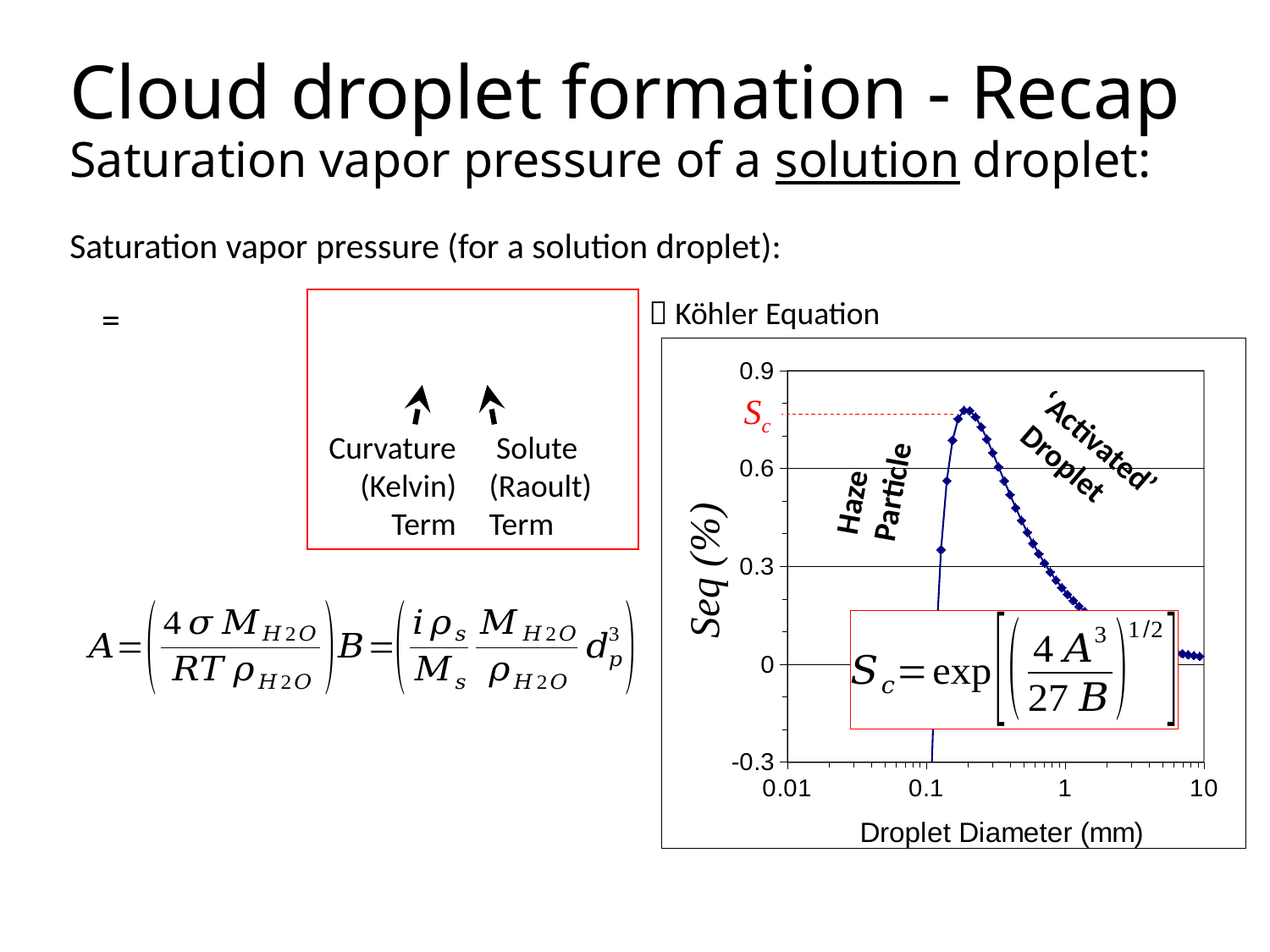
What label is written on the chart to the left of the curve's peak? Haze Particle What kind of chart is shown on the slide? line chart Is the peak value of the curve greater or less than 0.9? less What is the label of the x axis of the chart? Droplet Diameter (mm) Is the value of the curve at a droplet diameter of 10 mm greater or less than 0.3? less Is the value of the curve at a droplet diameter of 1 mm greater or less than 0.6? less After the peak, do the values of the curve rise or fall as droplet diameter increases? fall How many labelled tick values are shown on the y axis? 5 Between 0.1 mm and the peak, do the values of the curve rise or fall as droplet diameter increases? rise How many labelled tick values are shown on the x axis? 4